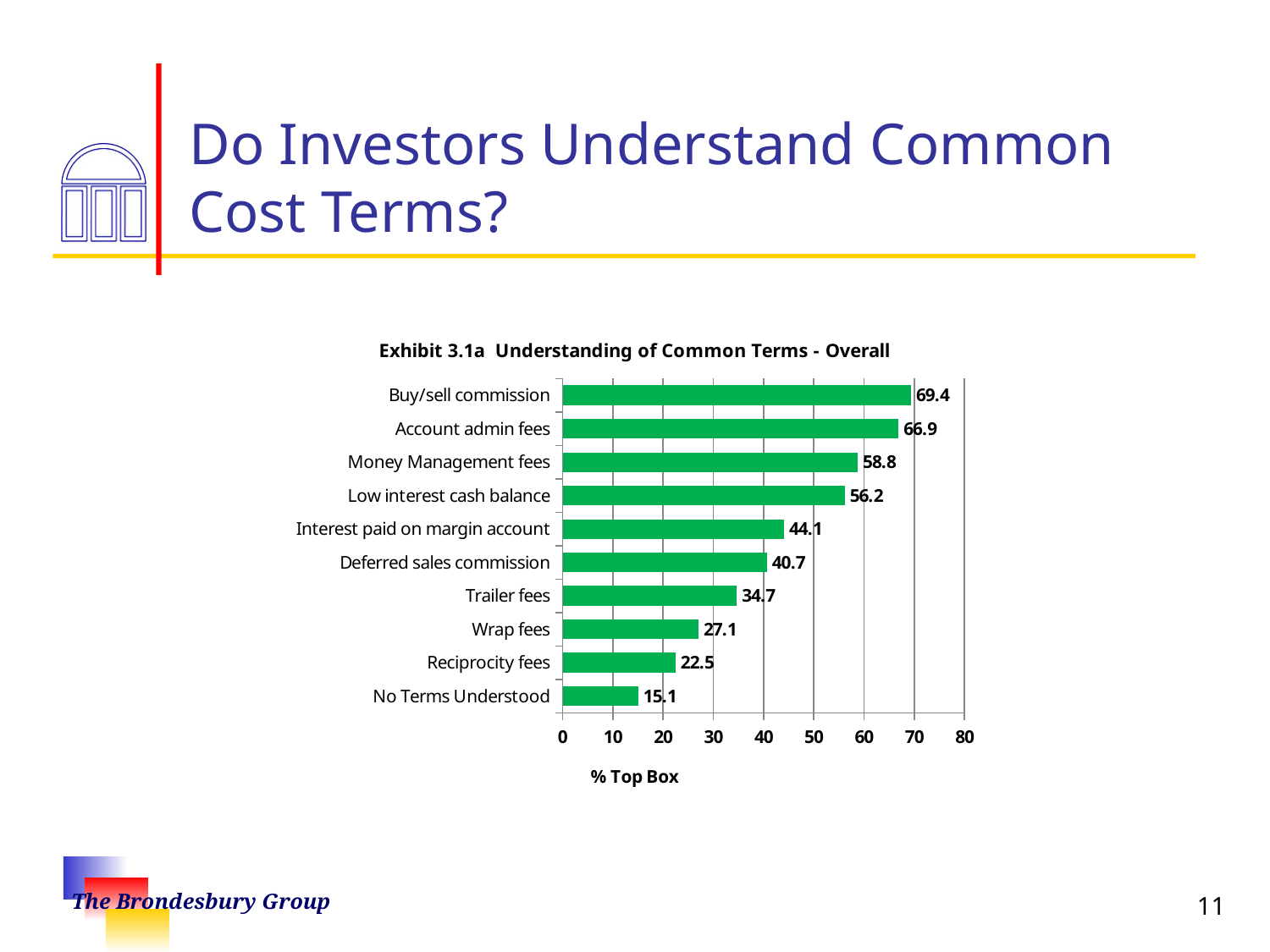
How many categories are shown in the chart? 10 Which is larger, the value for Deferred sales commission or the value for Wrap fees? Deferred sales commission Which category has the lowest value? No Terms Understood What is the title of the chart? Exhibit 3.1a Understanding of Common Terms - Overall Which category has the highest value? Buy/sell commission What is the value for Reciprocity fees? 22.5 What is the value for Trailer fees? 34.7 Is the value for Low interest cash balance greater or less than 50? greater What is the difference between the values for Account admin fees and Money Management fees? 8.1 What kind of chart is shown on the slide? bar chart What is the value for Buy/sell commission? 69.4 What is the label of the horizontal axis? % Top Box